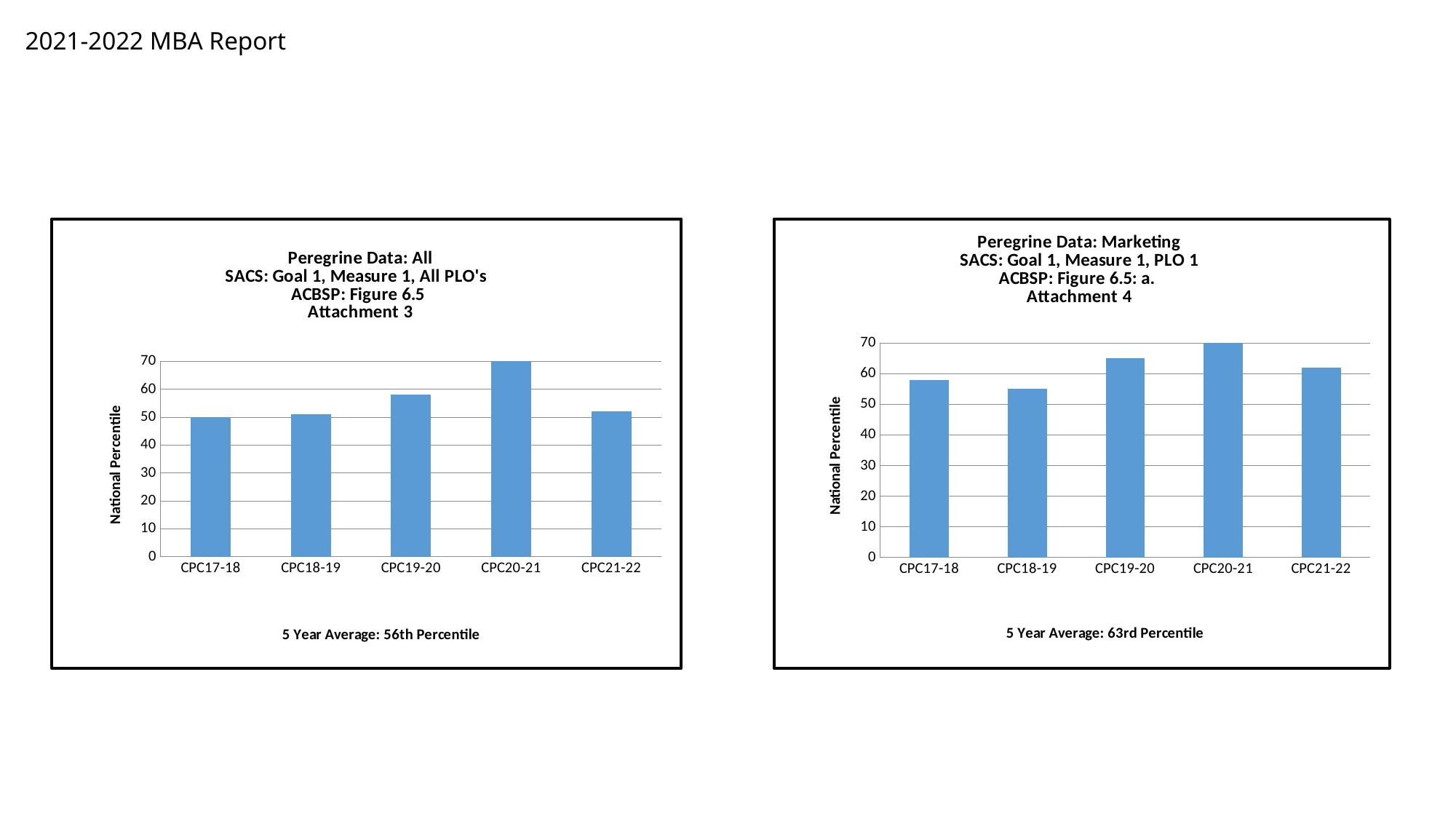
In the 'Peregrine Data: All' chart on the left, which year has the highest national percentile? CPC20-21 In the 'Peregrine Data: All' chart on the left, what is the national percentile for CPC20-21? 70 In the 'Peregrine Data: All' chart on the left, is the value for CPC19-20 greater or less than 50? greater In the 'Peregrine Data: All' chart on the left, what is the national percentile for CPC17-18? 50 In the 'Peregrine Data: Marketing' chart on the right, which year has the lowest national percentile? CPC18-19 In the 'Peregrine Data: All' chart on the left, which is larger, the value for CPC19-20 or CPC21-22? CPC19-20 In the 'Peregrine Data: Marketing' chart on the right, is the value for CPC18-19 greater or less than 60? less How many years are plotted in the 'Peregrine Data: Marketing' chart on the right? 5 In the 'Peregrine Data: Marketing' chart on the right, which is larger, the value for CPC17-18 or CPC19-20? CPC19-20 What 5 year average is stated below the 'Peregrine Data: Marketing' chart on the right? 63rd Percentile What kind of chart is the 'Peregrine Data: All' chart on the left? Bar chart